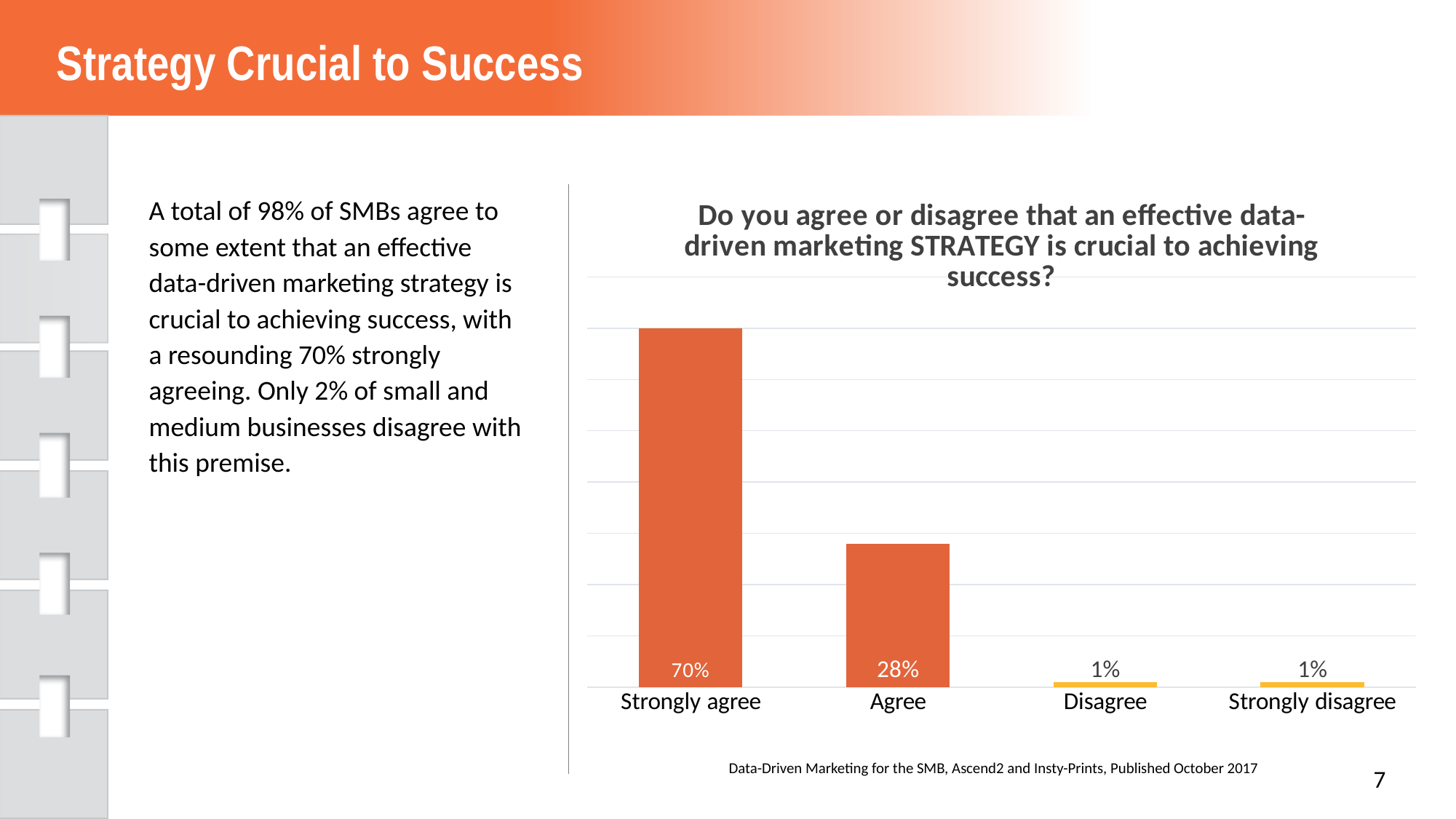
What is the title of the chart? Do you agree or disagree that an effective data-driven marketing STRATEGY is crucial to achieving success? What percentage of respondents answered "Strongly disagree"? 1% Which is larger, the value for "Agree" or the value for "Strongly disagree"? Agree Which response category has the highest value? Strongly agree What percentage of respondents answered "Agree"? 28% What is the difference between the "Strongly agree" and "Agree" values? 42% How many response categories are shown on the x axis? 4 What is the difference between the "Agree" and "Disagree" values? 27% What percentage of respondents answered "Strongly agree"? 70% What percentage of respondents answered "Disagree"? 1% What kind of chart is shown on the slide? Bar chart Do the values rise or fall moving from left to right along the x axis? Fall